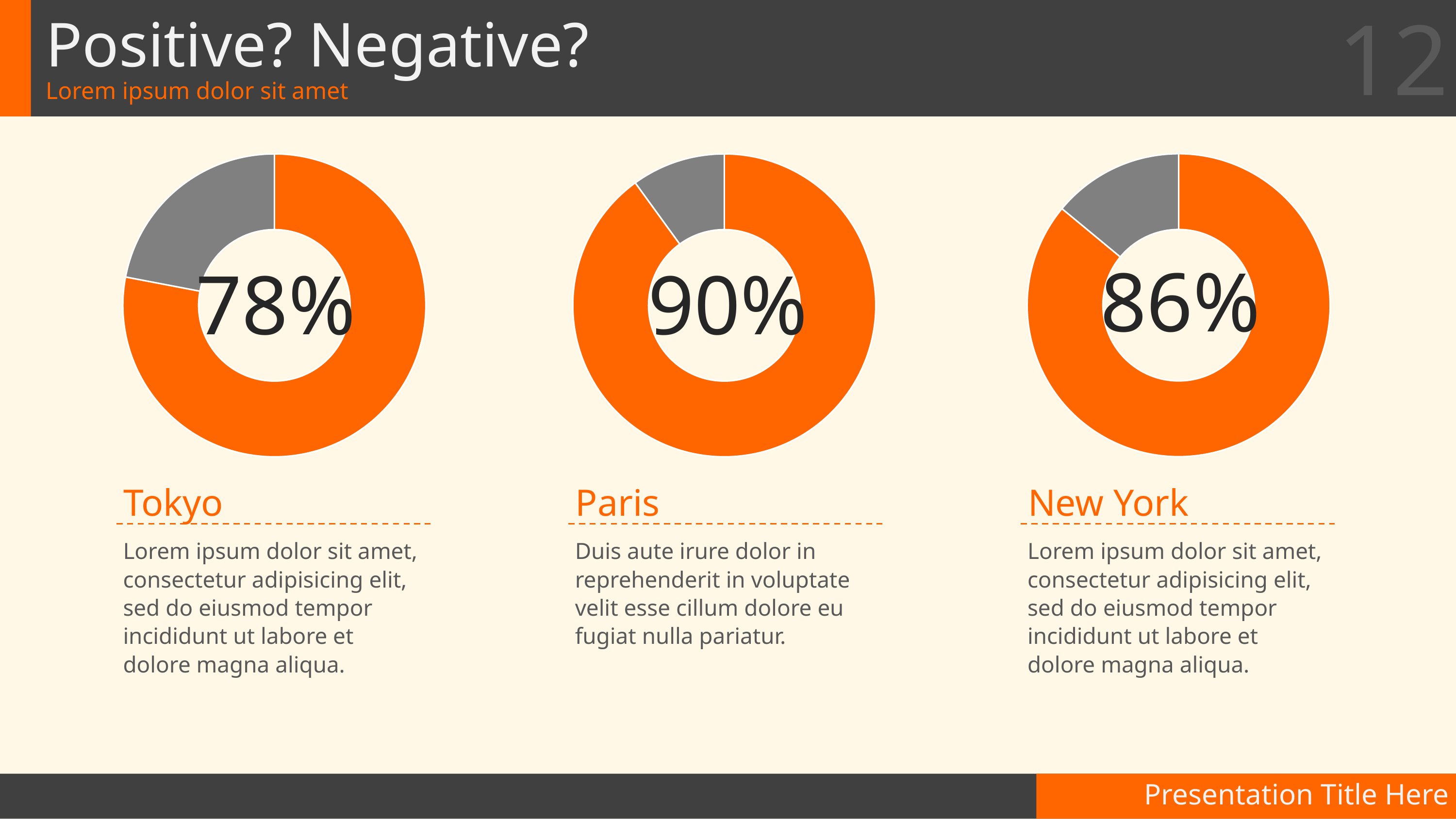
What kind of chart is used for each city on this slide? Donut chart What is the difference between the New York percentage and the Tokyo percentage? 8% Which is larger, the percentage for New York or the percentage for Paris? Paris Which city's donut chart shows the highest percentage? Paris What is the difference between the Paris percentage and the Tokyo percentage? 12% In the Tokyo donut chart, what share of the ring is grey? 22% What colour is the larger slice in each donut chart? Orange What percentage is shown in the New York donut chart? 86% Which city's donut chart shows the lowest percentage? Tokyo What percentage is shown in the Paris donut chart? 90% How many donut charts are on the slide? 3 What percentage is shown in the Tokyo donut chart? 78%